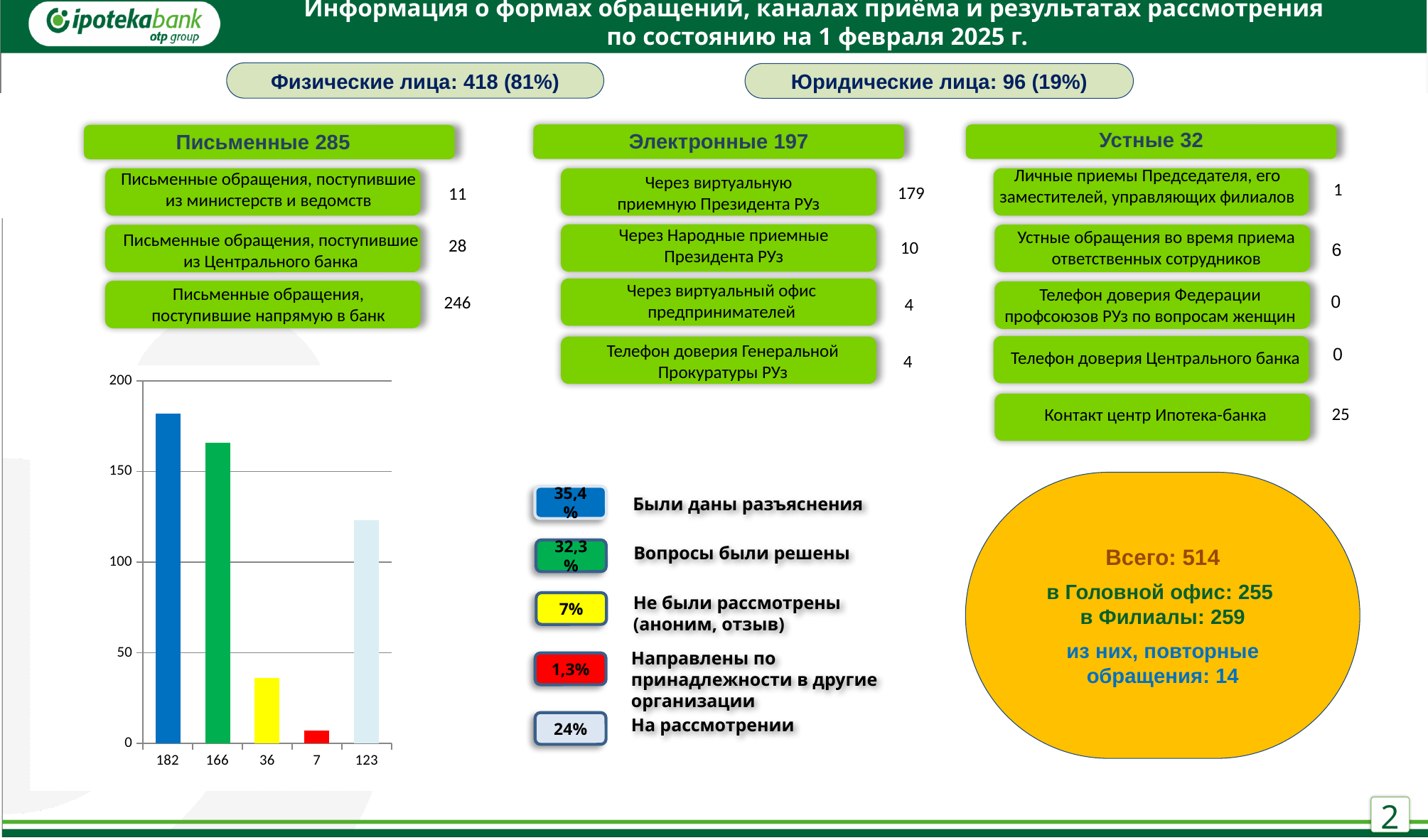
What is the value of the yellow bar (Не были рассмотрены) in the bar chart? 36 What is the difference between the blue bar (182) and the green bar (166) in the bar chart? 16 Which is larger in the bar chart: the light blue bar (На рассмотрении) or the yellow bar (Не были рассмотрены)? the light blue bar (На рассмотрении) Which bar in the bar chart has the lowest value? 7 (red, Направлены по принадлежности в другие организации) Which bar in the bar chart has the highest value? 182 (blue, Были даны разъяснения) What is the value of the red bar (Направлены по принадлежности в другие организации) in the bar chart? 7 What is the value of the blue bar (Были даны разъяснения) in the bar chart? 182 What kind of chart is shown on the slide? bar chart What is the value of the green bar (Вопросы были решены) in the bar chart? 166 How many bars does the bar chart have? 5 What percentage is shown in the legend for the category Вопросы были решены? 32,3% What is the value of the light blue bar (На рассмотрении) in the bar chart? 123